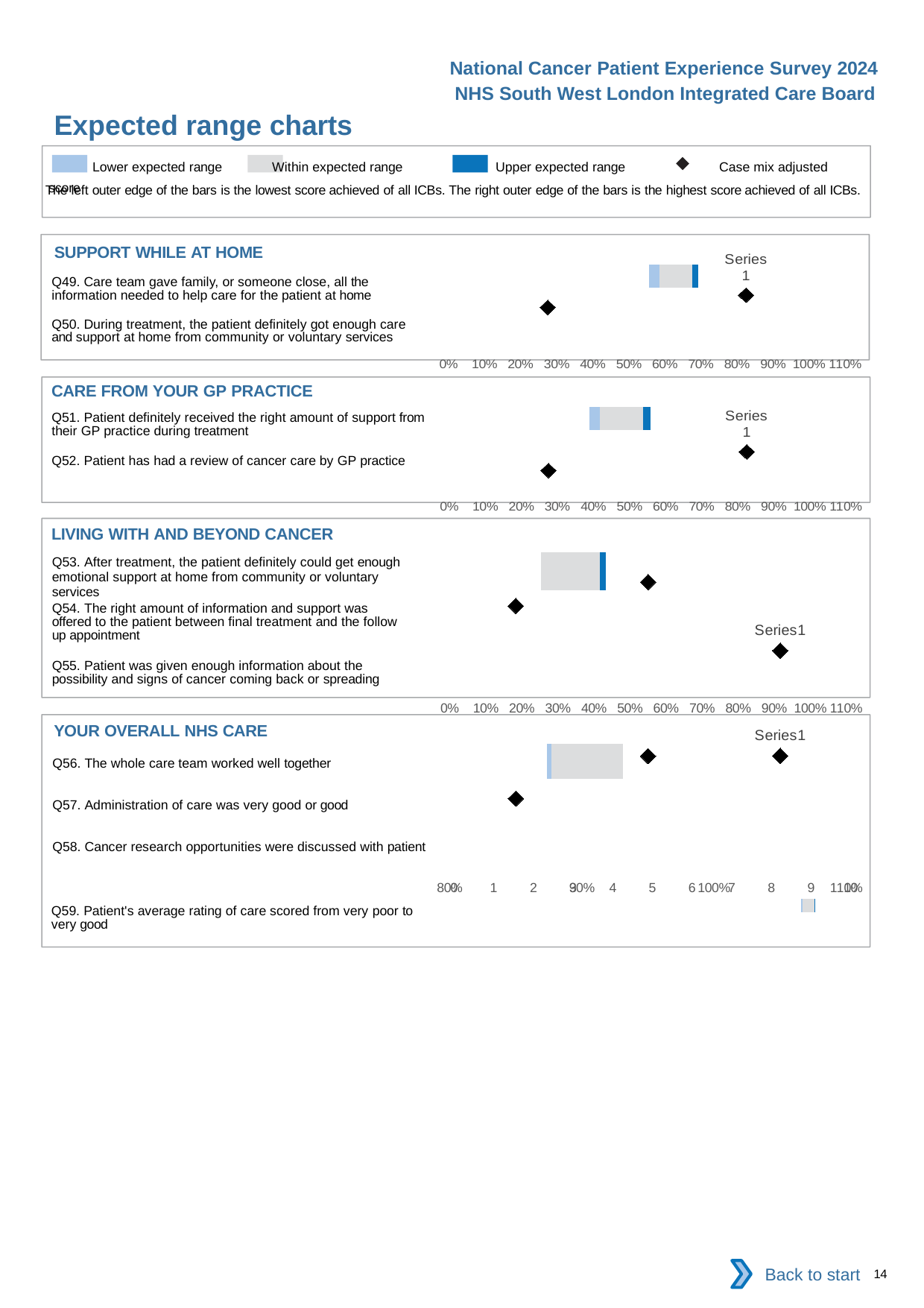
How many section charts are shown on the slide? 4 How many questions are listed in the YOUR OVERALL NHS CARE chart? 4 In the LIVING WITH AND BEYOND CANCER chart, how many diamond markers are plotted? 3 What is the highest tick label on the x axis of the SUPPORT WHILE AT HOME chart? 110% In the SUPPORT WHILE AT HOME chart, is the leftmost diamond marker greater or less than 50%? less How many entries does the legend at the top of the slide list? 4 What kind of chart is used in the Expected range charts on this slide? bar chart In the SUPPORT WHILE AT HOME chart, is the rightmost diamond marker greater or less than 70%? greater According to the legend, what does the diamond marker represent? Case mix adjusted score